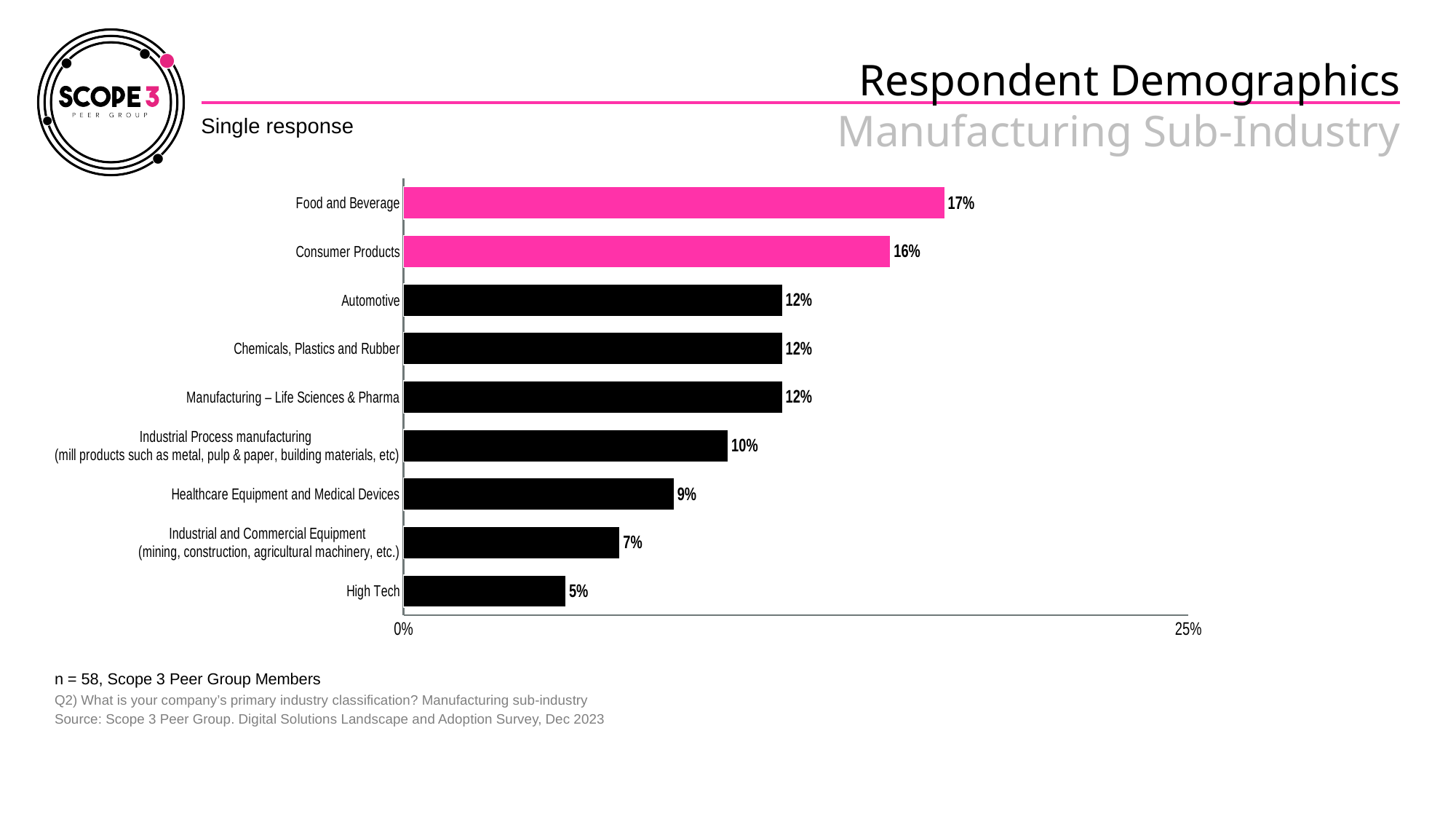
Which is larger, the value for Industrial Process manufacturing or the value for Healthcare Equipment and Medical Devices? Industrial Process manufacturing What is the difference between the values for Food and Beverage and High Tech? 12% Which bars are coloured pink rather than black? Food and Beverage and Consumer Products Which manufacturing sub-industry has the highest share of respondents? Food and Beverage What kind of chart is shown on the slide? Bar chart Which manufacturing sub-industry has the lowest share of respondents? High Tech What is the value for Consumer Products? 16% How many categories share the value of 12%? 3 How many manufacturing sub-industry categories are shown in the chart? 9 What is the value for Healthcare Equipment and Medical Devices? 9% What percentage of respondents are in Food and Beverage? 17% What is the value for High Tech? 5%